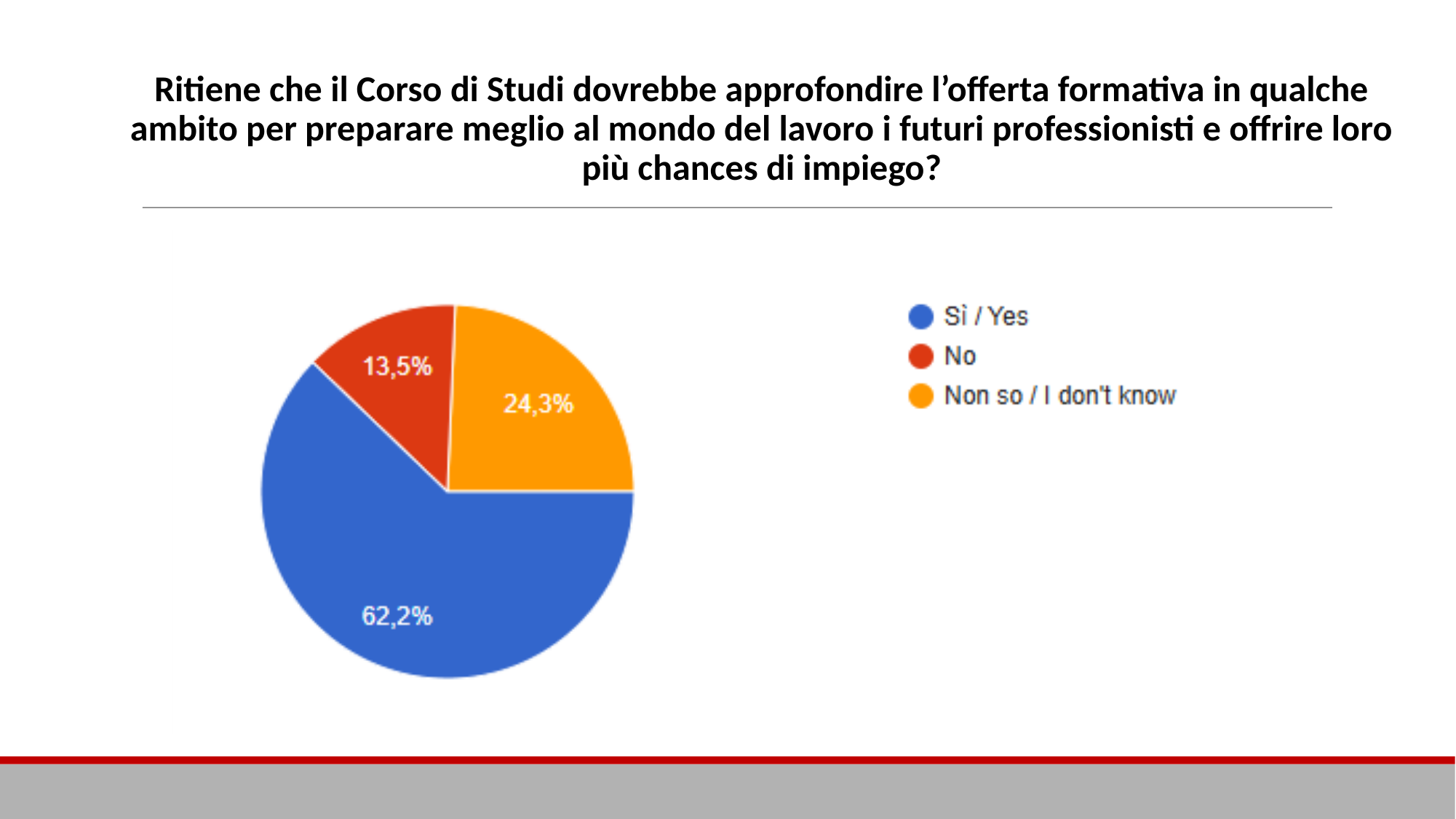
What share of the pie does the "Non so / I don't know" slice represent? 24,3% What is the difference in percentage points between the "Non so / I don't know" slice and the "No" slice? 10,8 How many entries does the legend list? 3 Which category has the largest slice of the pie? Sì / Yes What is the difference in percentage points between the "Sì / Yes" slice and the "Non so / I don't know" slice? 37,9 How many slices does the pie chart have? 3 Which is larger, the "No" slice or the "Non so / I don't know" slice? Non so / I don't know Which category has the smallest slice of the pie? No What colour is the "Non so / I don't know" slice? orange What kind of chart is shown on the slide? pie chart What share of the pie does the "Sì / Yes" slice represent? 62,2% What share of the pie does the "No" slice represent? 13,5%